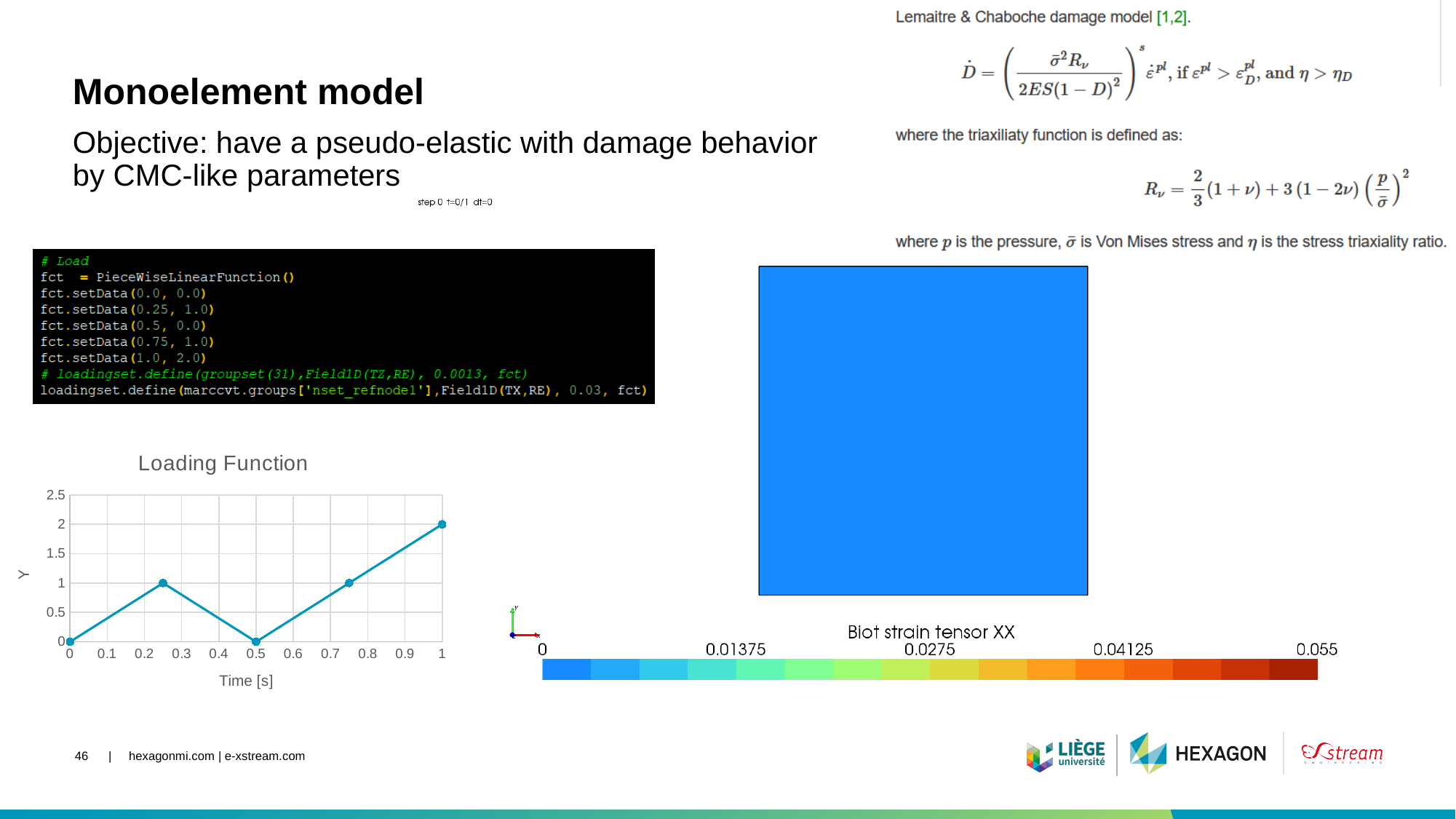
What is the x-axis label of the Loading Function chart? Time [s] In the Loading Function chart, what is the value of Y at time 1 s? 2 In the Loading Function chart, at which time does Y reach its highest value? 1 What type of chart is the Loading Function chart? line chart In the Loading Function chart, is the Y value at time 1 s greater or less than 1.5? greater In the Loading Function chart, what is the value of Y at time 0.5 s? 0 What is the title of the chart at the bottom left of the slide? Loading Function In the Loading Function chart, is the Y value at time 0.25 s larger or smaller than the Y value at time 0.5 s? larger In the Loading Function chart, what is the difference between the Y value at time 1 s and the Y value at time 0.75 s? 1 In the Loading Function chart, what is the value of Y at time 0.25 s? 1 How many data points are plotted in the Loading Function chart? 5 In the Loading Function chart, does Y rise or fall between time 0.5 s and time 1 s? rise